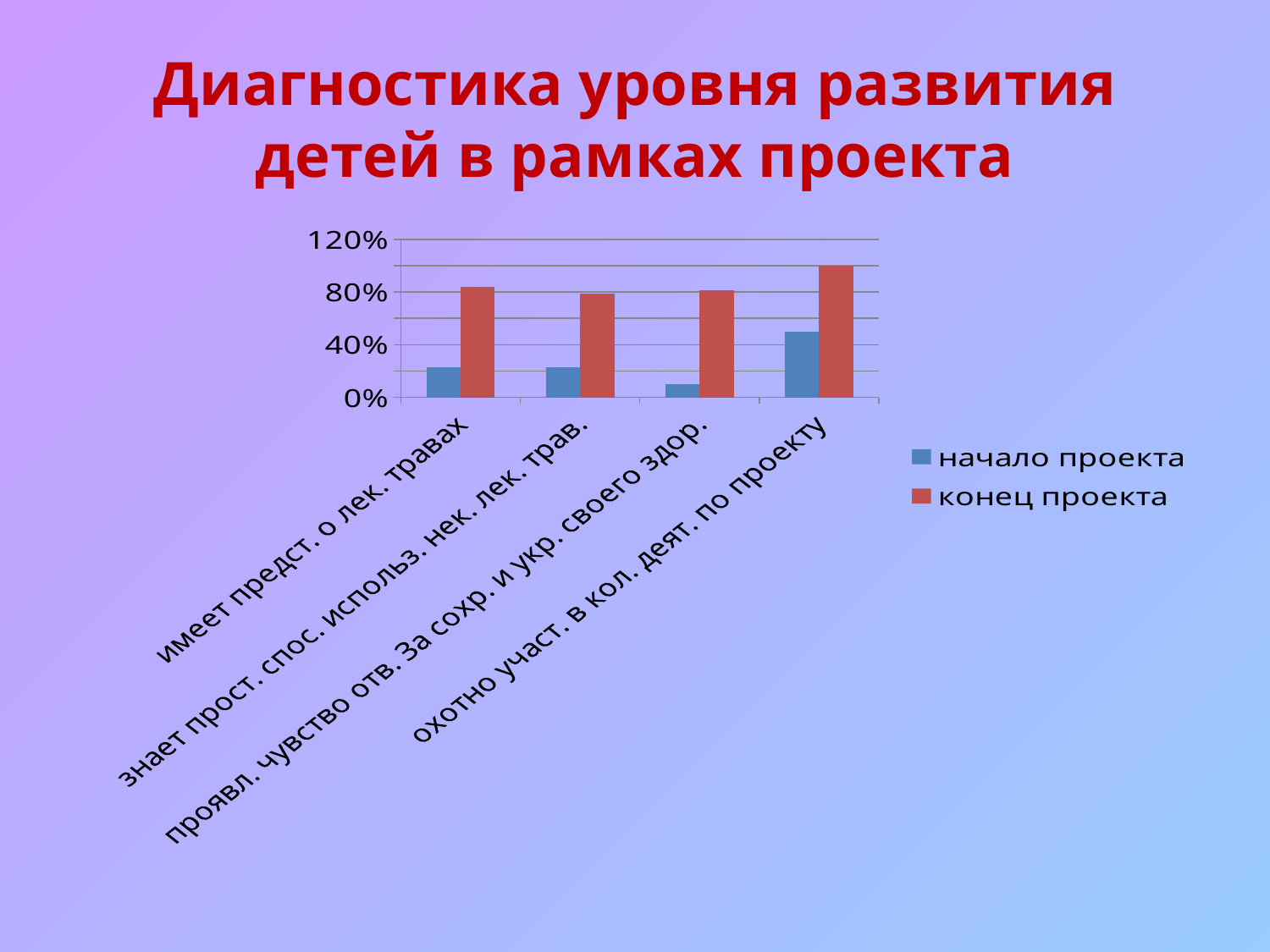
Which category has the lowest value for the series "начало проекта"? проявл. чувство отв. за сохр. и укр. своего здор. What is the title of the slide containing the chart? Диагностика уровня развития детей в рамках проекта Is the value for "начало проекта" in the category "охотно участ. в кол. деят. по проекту" greater or less than 40%? greater What are the two series named in the chart legend? начало проекта, конец проекта For the category "знает прост. спос. использ. нек. лек. трав.", which series has the larger value, "начало проекта" or "конец проекта"? конец проекта How many series does the chart legend list? 2 How many categories are shown on the x axis of the chart? 4 Is the value for "начало проекта" in the category "имеет предст. о лек. травах" greater or less than 40%? less Which category has the highest value for the series "конец проекта"? охотно участ. в кол. деят. по проекту Is the value for "конец проекта" in the category "охотно участ. в кол. деят. по проекту" greater or less than 80%? greater Which category has the highest value for the series "начало проекта"? охотно участ. в кол. деят. по проекту What kind of chart is shown on the slide? bar chart